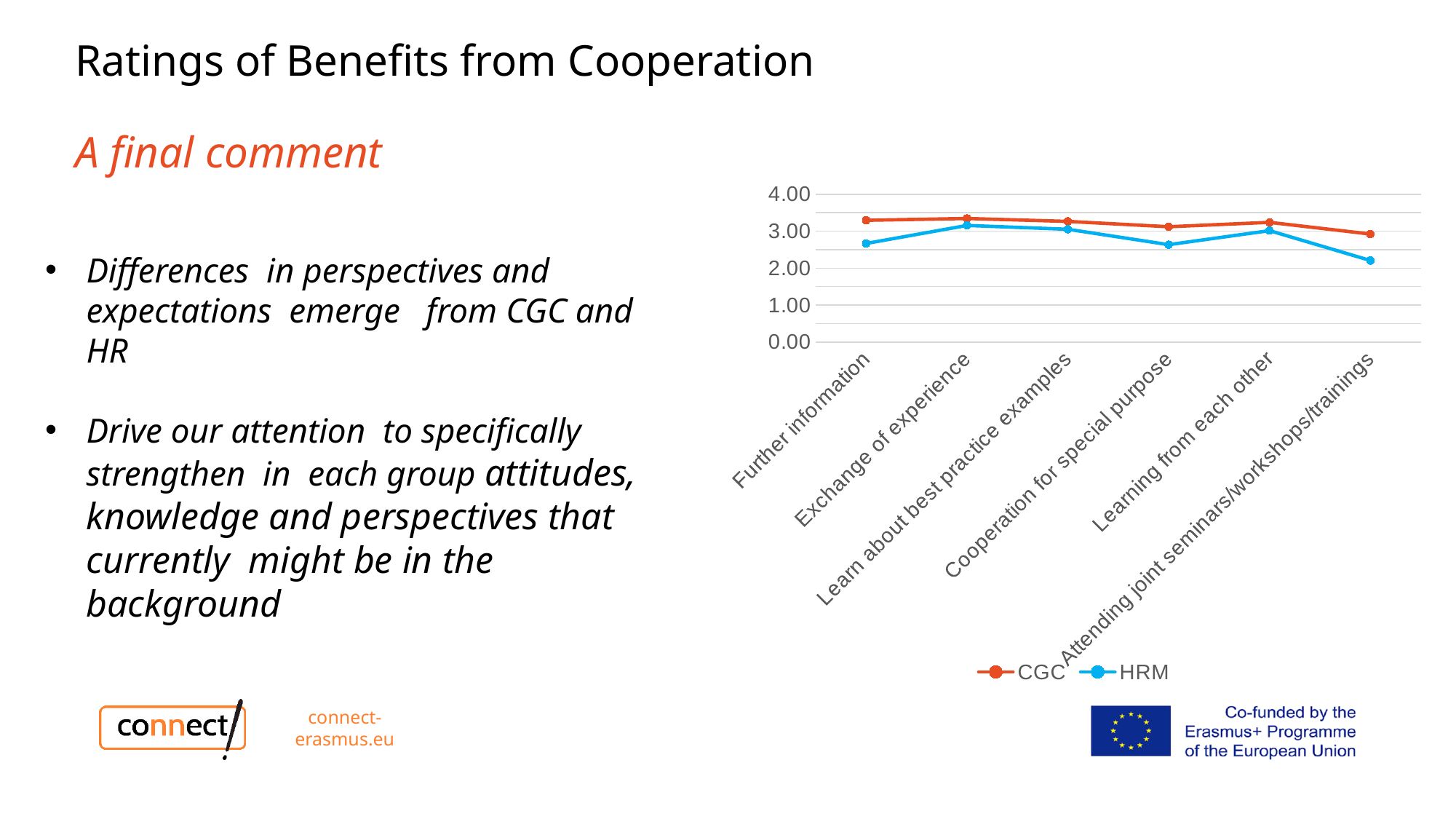
Is the HRM value for Attending joint seminars/workshops/trainings greater or less than 2.00? greater For Attending joint seminars/workshops/trainings, which series has the higher value, CGC or HRM? CGC Does the HRM line rise or fall from Learning from each other to Attending joint seminars/workshops/trainings? fall How many categories are plotted along the x axis of the chart? 6 How many series does the chart legend list? 2 Is the HRM value for Attending joint seminars/workshops/trainings greater or less than 3.00? less For which category is the HRM value lowest? Attending joint seminars/workshops/trainings Which series is drawn in orange-red in the chart? CGC Is the HRM value for Further information greater or less than 3.00? less Which series is drawn in blue in the chart? HRM What kind of chart is shown on the slide? line chart